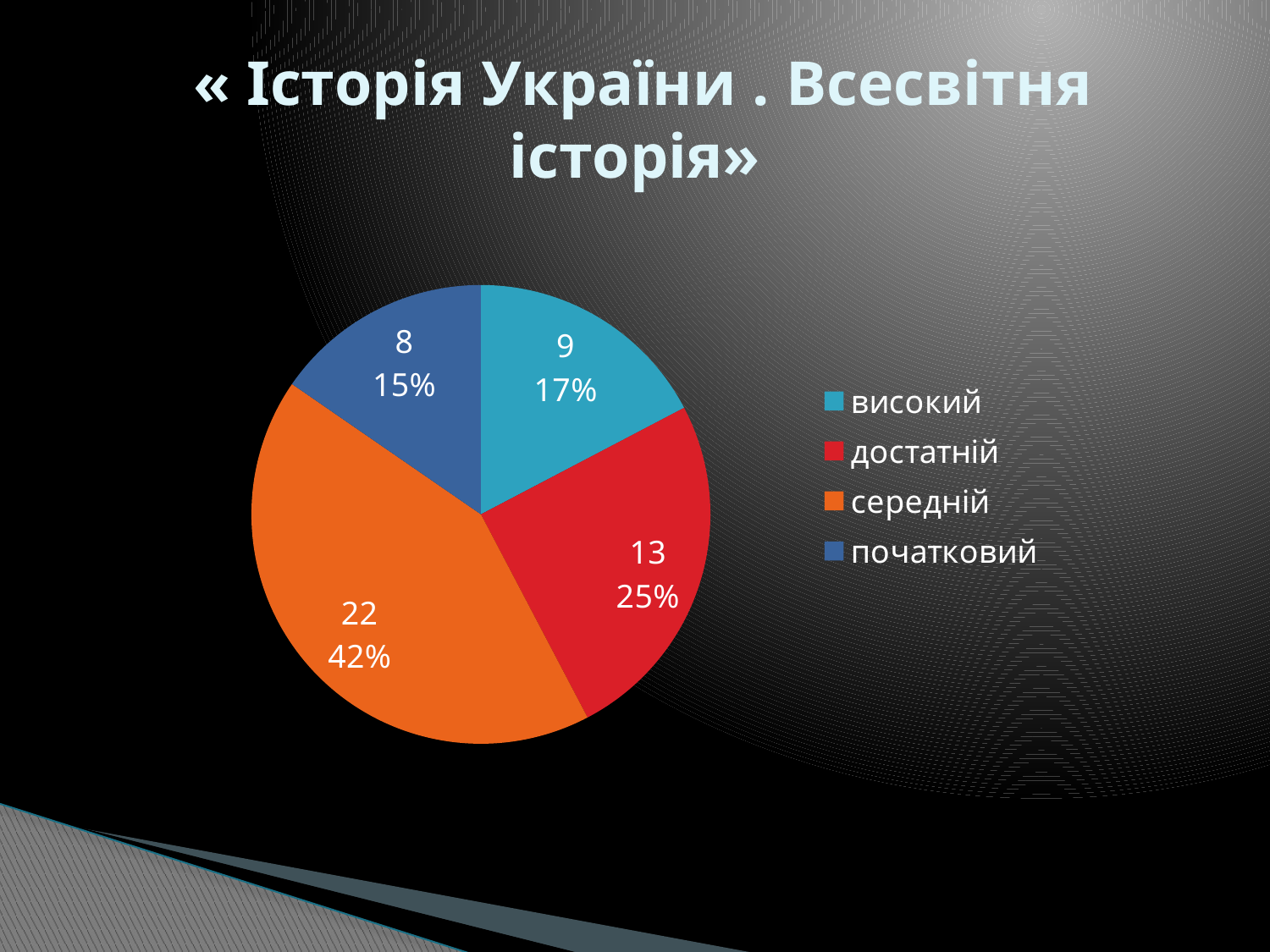
What share of the pie does the 'середній' slice represent? 42% How many entries does the legend list? 4 Which category has the largest slice? середній What is the difference between the values for 'середній' and 'достатній'? 9 What kind of chart is shown on the slide? pie chart What is the value for the 'середній' slice? 22 How many slices does the pie chart have? 4 What share of the pie does the 'початковий' slice represent? 15% What is the value for the 'достатній' slice? 13 Which category has the smallest slice? початковий What is the value for the 'початковий' slice? 8 What is the value for the 'високий' slice? 9